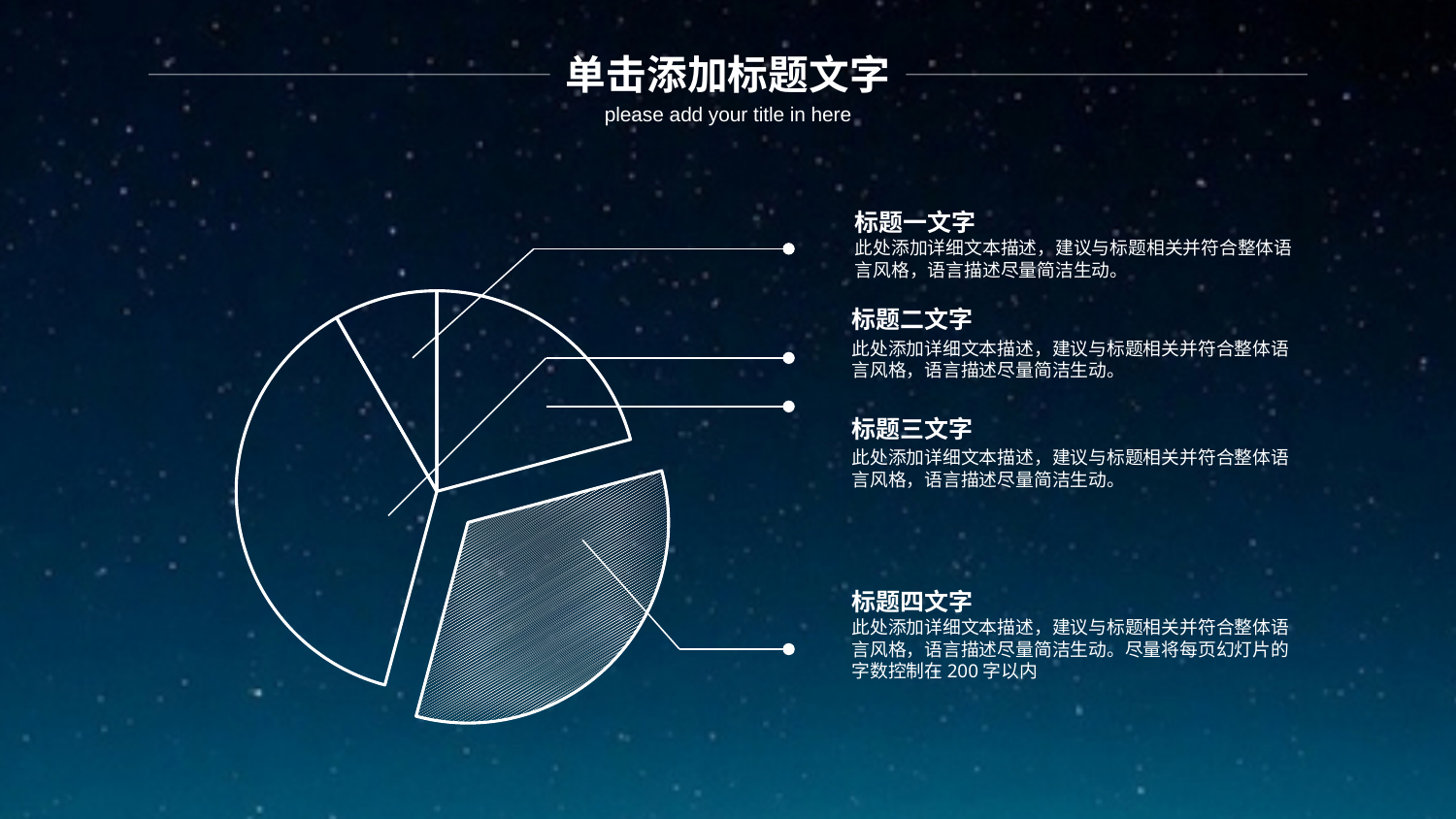
Which slice of the pie chart is filled with a hatched pattern and pulled out from the rest? 标题四文字 What kind of chart is shown on the slide? pie chart How many slices does the pie chart have? 4 How many labelled callouts point to the pie chart? 4 Which is larger, the slice labelled 标题四文字 or the slice labelled 标题一文字? 标题四文字 Which labelled slice of the pie chart is the smallest? 标题一文字 Does the pie chart display any numeric data labels on its slices? No